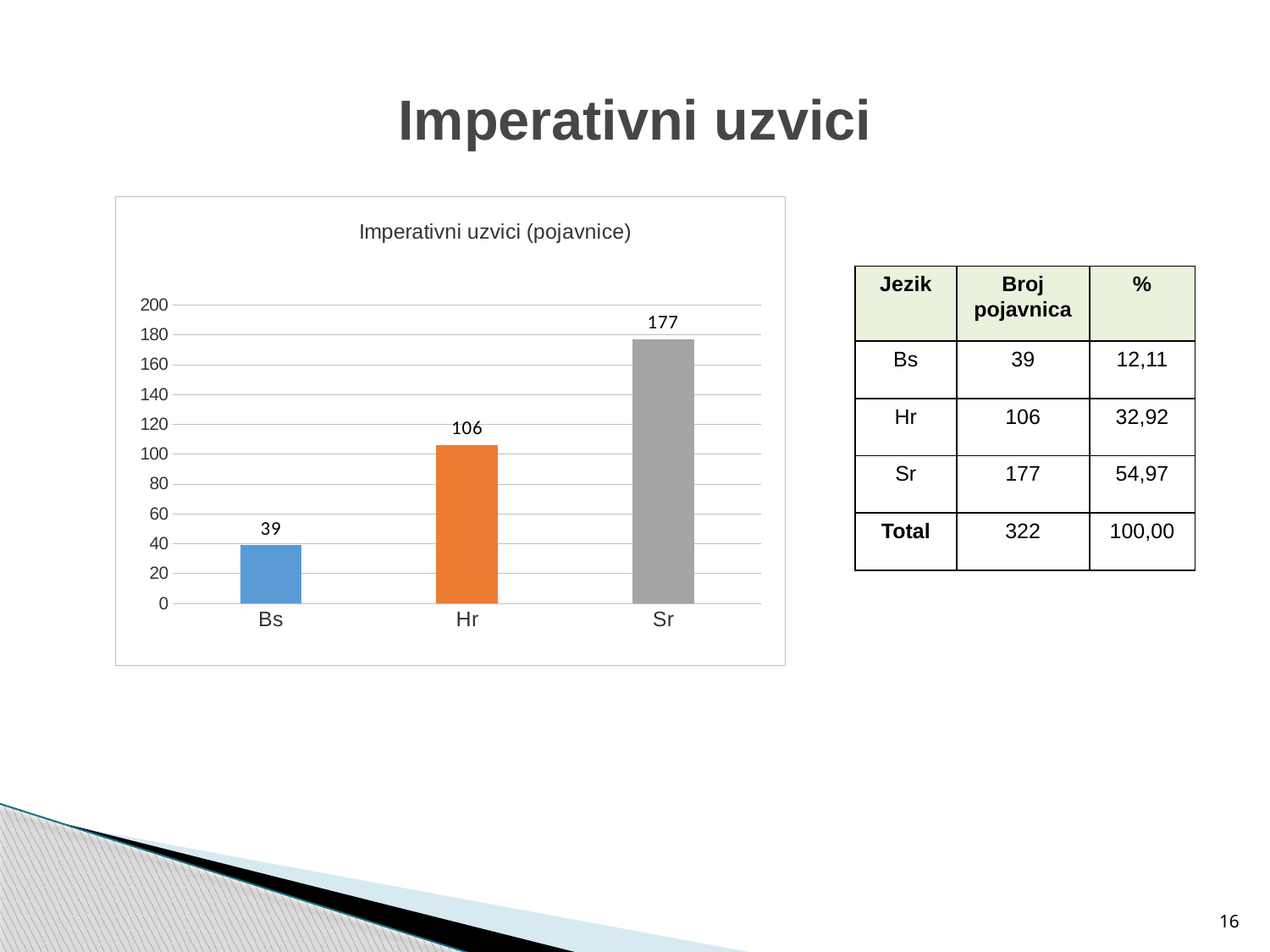
Which category has the highest value in the chart? Sr What is the difference between the values for Sr and Hr? 71 What is the title of the chart? Imperativni uzvici (pojavnice) What is the value for Bs in the chart? 39 What is the difference between the values for Hr and Bs? 67 Is the value for Sr greater or less than 160? greater What is the value for Hr in the chart? 106 Which is larger, the value for Bs or the value for Hr? Hr What kind of chart is shown on the slide? bar chart How many categories are shown on the x axis of the chart? 3 Which category has the lowest value in the chart? Bs What is the value for Sr in the chart? 177